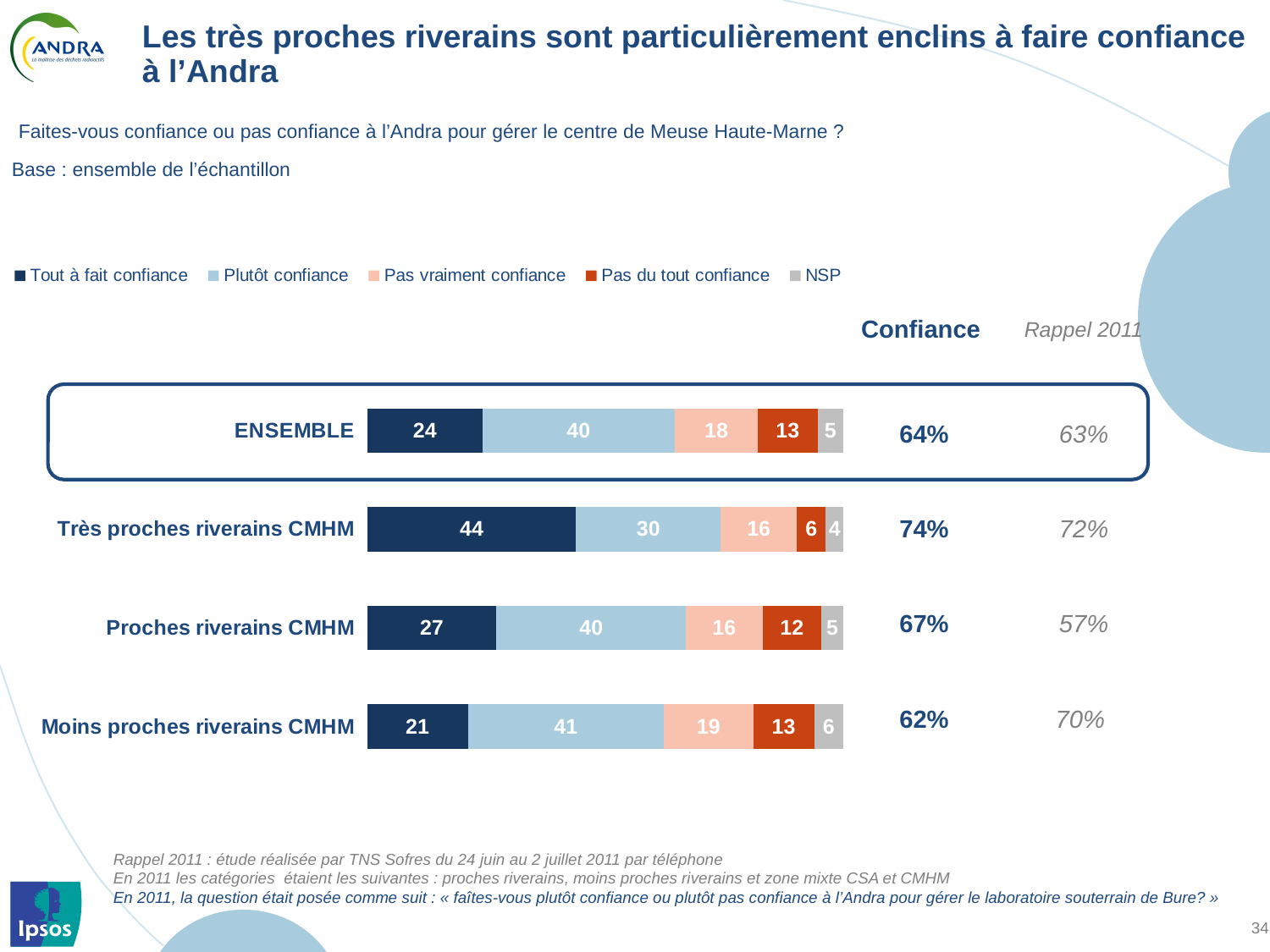
What kind of chart is shown on the slide? Stacked bar chart What is the first entry in the chart legend? Tout à fait confiance What is the 'NSP' value for 'Moins proches riverains CMHM'? 6 What is the value of 'Plutôt confiance' for 'Moins proches riverains CMHM'? 41 How many categories are shown in the chart? 4 What is the total of the stacked bar for 'ENSEMBLE'? 100 What is the difference between the 'Tout à fait confiance' values for 'Très proches riverains CMHM' and 'ENSEMBLE'? 20 Which category has the lowest 'Tout à fait confiance' value? Moins proches riverains CMHM Which has the larger 'Pas du tout confiance' value, 'ENSEMBLE' or 'Très proches riverains CMHM'? ENSEMBLE How many series does the legend list? 5 What is the value of 'Tout à fait confiance' for 'Très proches riverains CMHM'? 44 Which category has the highest 'Tout à fait confiance' value? Très proches riverains CMHM